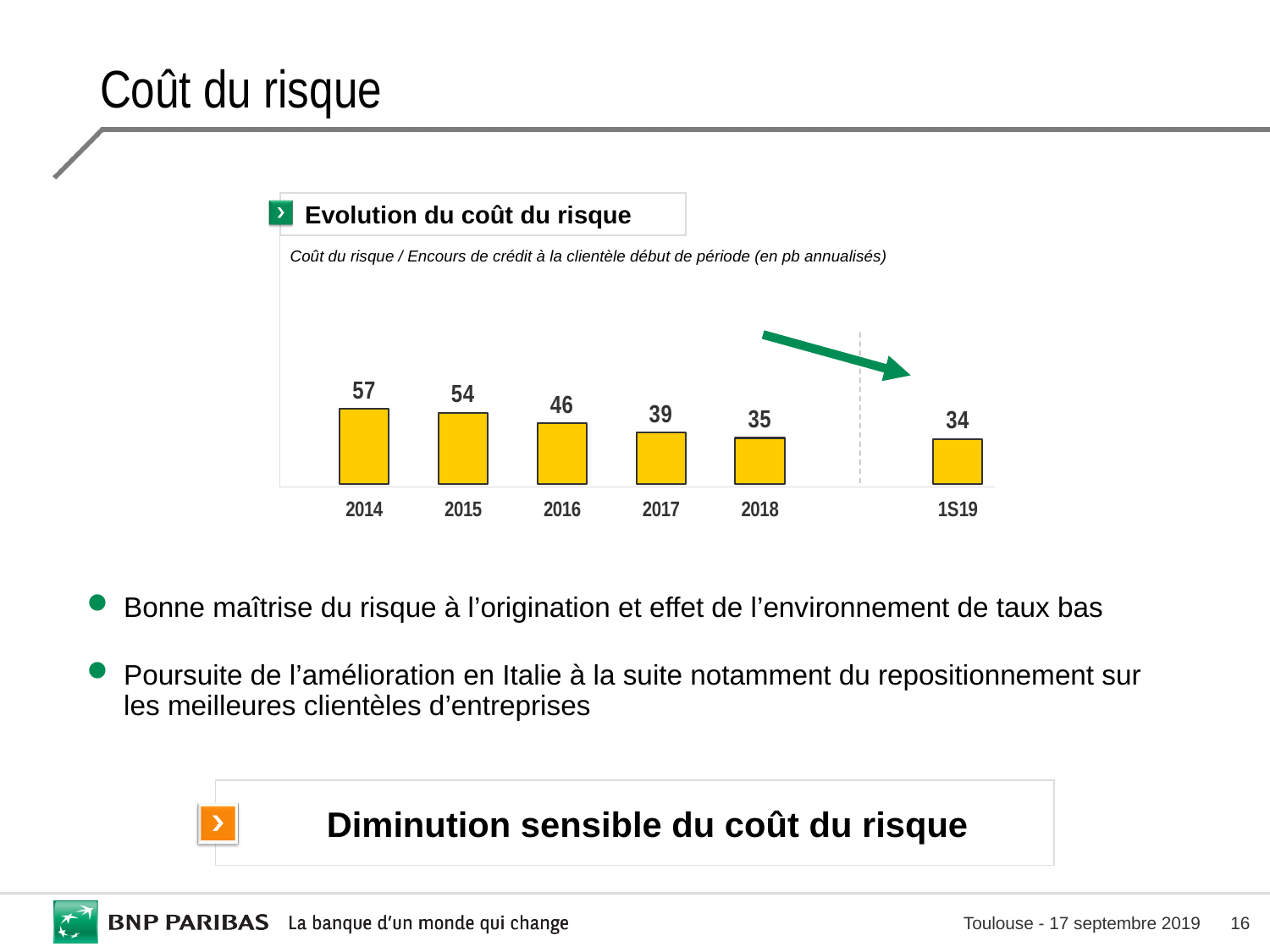
What is the value for 1S19? 34 Do the values rise or fall from 2014 to 1S19? fall Which is larger, the value for 2016 or the value for 2017? 2016 What is the difference between the values for 2014 and 2018? 22 How many categories are shown on the x axis? 6 What is the value for 2014? 57 Which category has the highest value? 2014 What is the title of the chart? Evolution du coût du risque What is the difference between the values for 2015 and 2016? 8 Which category has the lowest value? 1S19 What kind of chart is shown? bar chart What is the value for 2017? 39